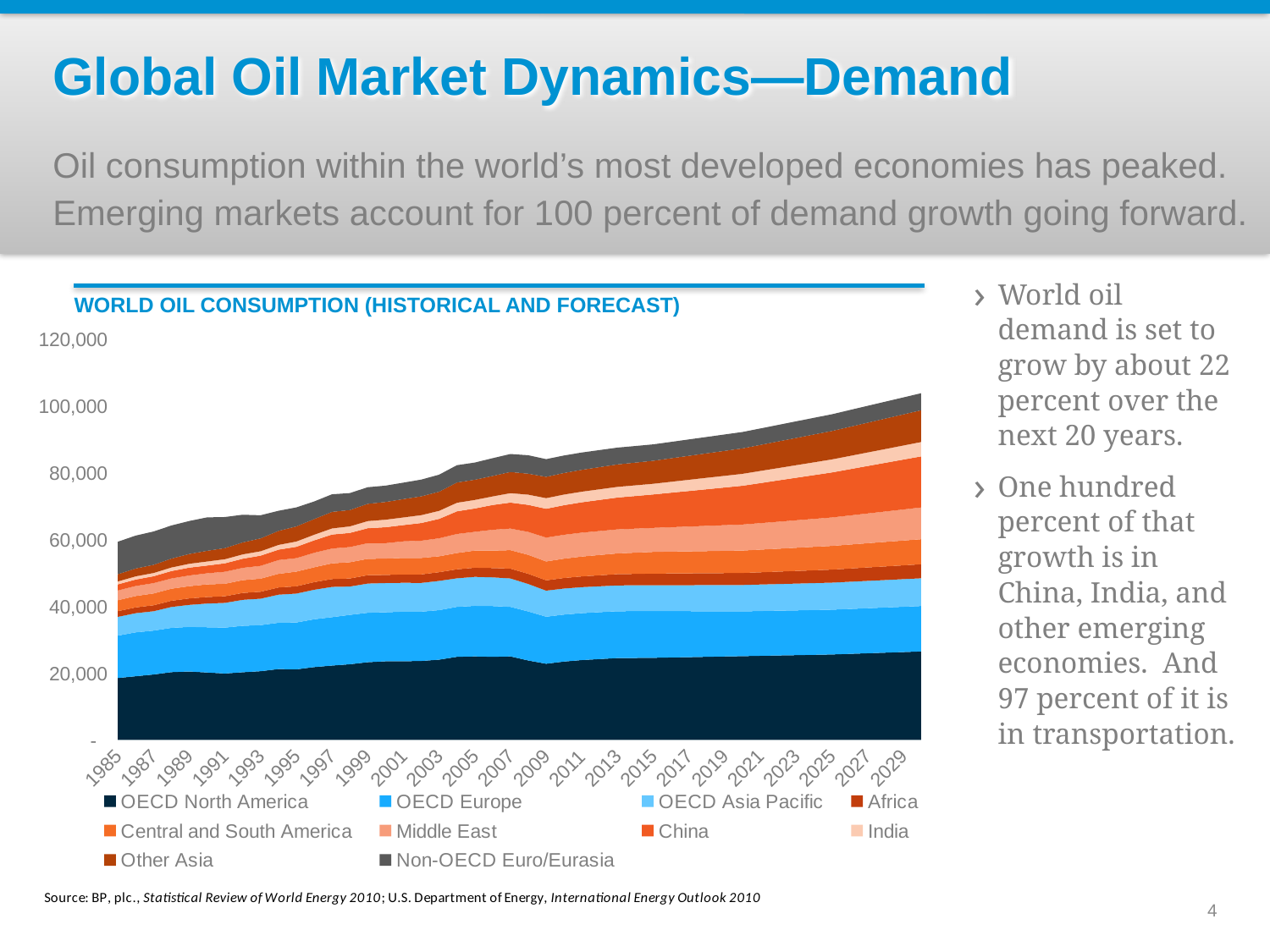
Which series is plotted at the bottom of the stacked area chart? OECD North America What is the highest value labelled on the chart's y axis? 120,000 Is the total world oil consumption in 1985 greater or less than 40,000? greater Is the total world oil consumption in 1985 greater or less than 80,000? less Does total world oil consumption rise or fall from 1985 to 2029 in the chart? Rise What is the last year shown on the chart's x axis? 2029 What is the first year shown on the chart's x axis? 1985 What kind of chart is shown on the slide? Stacked area chart How many series does the chart's legend list? 10 What is the title of the chart? WORLD OIL CONSUMPTION (HISTORICAL AND FORECAST) Is the total world oil consumption in 2029 greater or less than 120,000? less